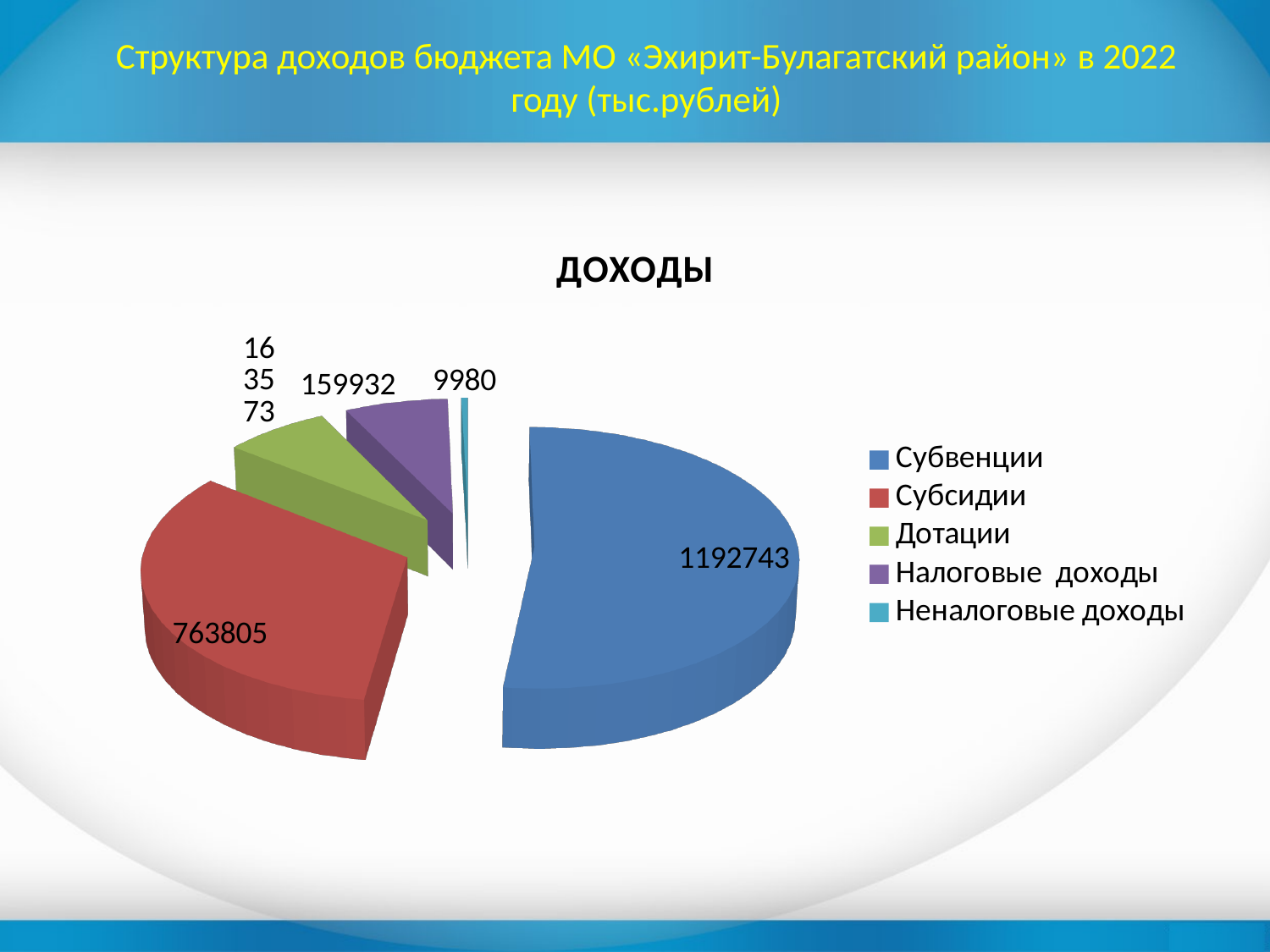
What is the value for Неналоговые доходы? 9980 What is the title of the chart? ДОХОДЫ How many slices does the pie chart have? 5 What is the value for Налоговые доходы? 159932 Which category has the largest slice? Субвенции What is the value for Субсидии? 763805 What is the difference between the values for Субвенции and Субсидии? 428938 Which category has the smallest slice? Неналоговые доходы What type of chart is shown on the slide? pie chart Which is larger, Субсидии or Налоговые доходы? Субсидии What is the value for Субвенции? 1192743 How many entries does the legend list? 5